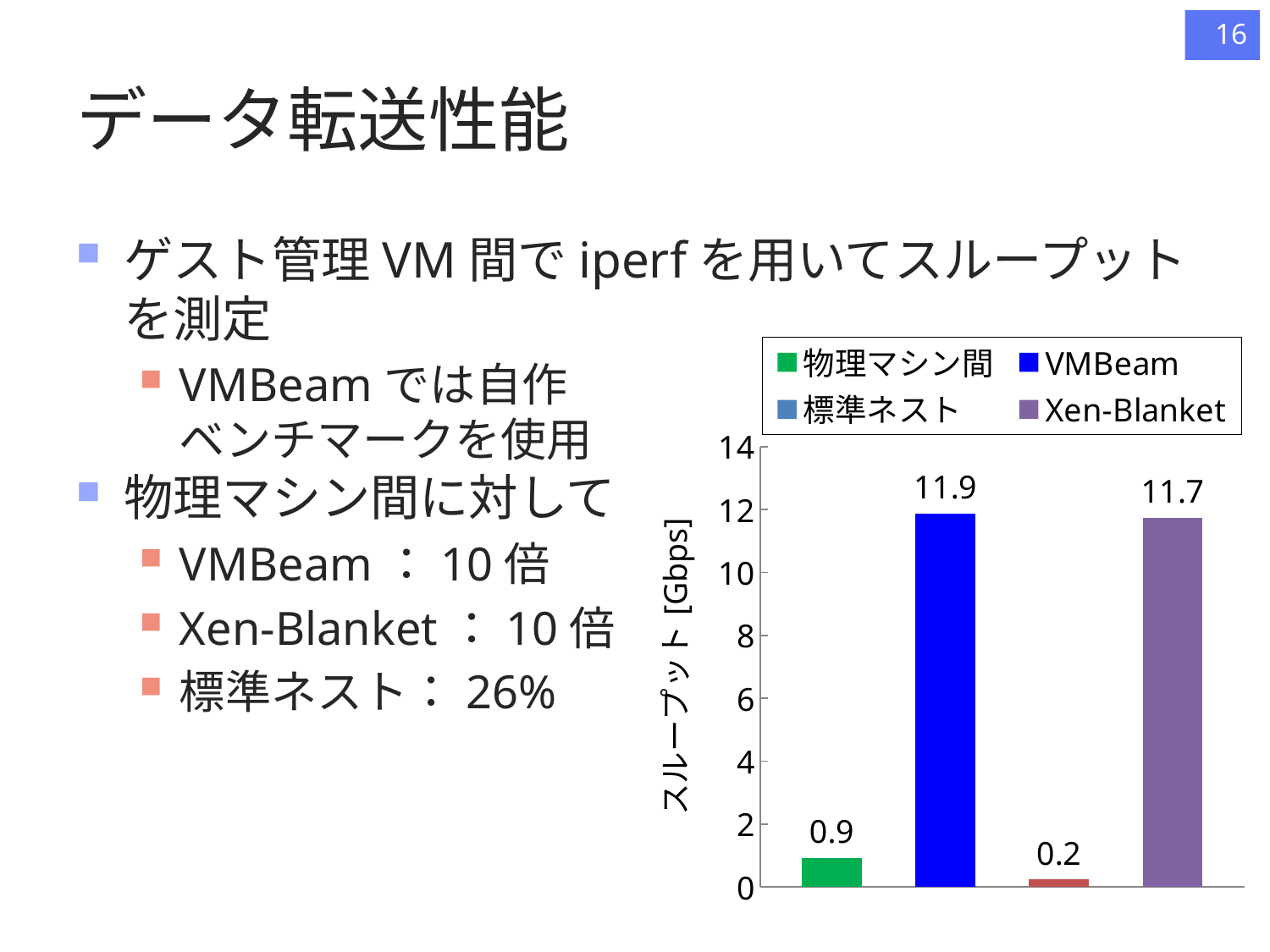
Which series has the lowest throughput in the chart? 標準ネスト Which series has the highest throughput in the chart? VMBeam What is the throughput value shown for 物理マシン間? 0.9 What is the difference between the throughput of 物理マシン間 and 標準ネスト? 0.7 What is the label of the vertical axis of the chart? スループット [Gbps] Which has a higher throughput, 物理マシン間 or Xen-Blanket? Xen-Blanket What is the throughput value shown for Xen-Blanket? 11.7 What kind of chart is shown on the slide? bar chart What is the difference between the throughput of VMBeam and Xen-Blanket? 0.2 What is the throughput value shown for 標準ネスト? 0.2 What is the throughput value shown for VMBeam? 11.9 How many series does the legend list? 4